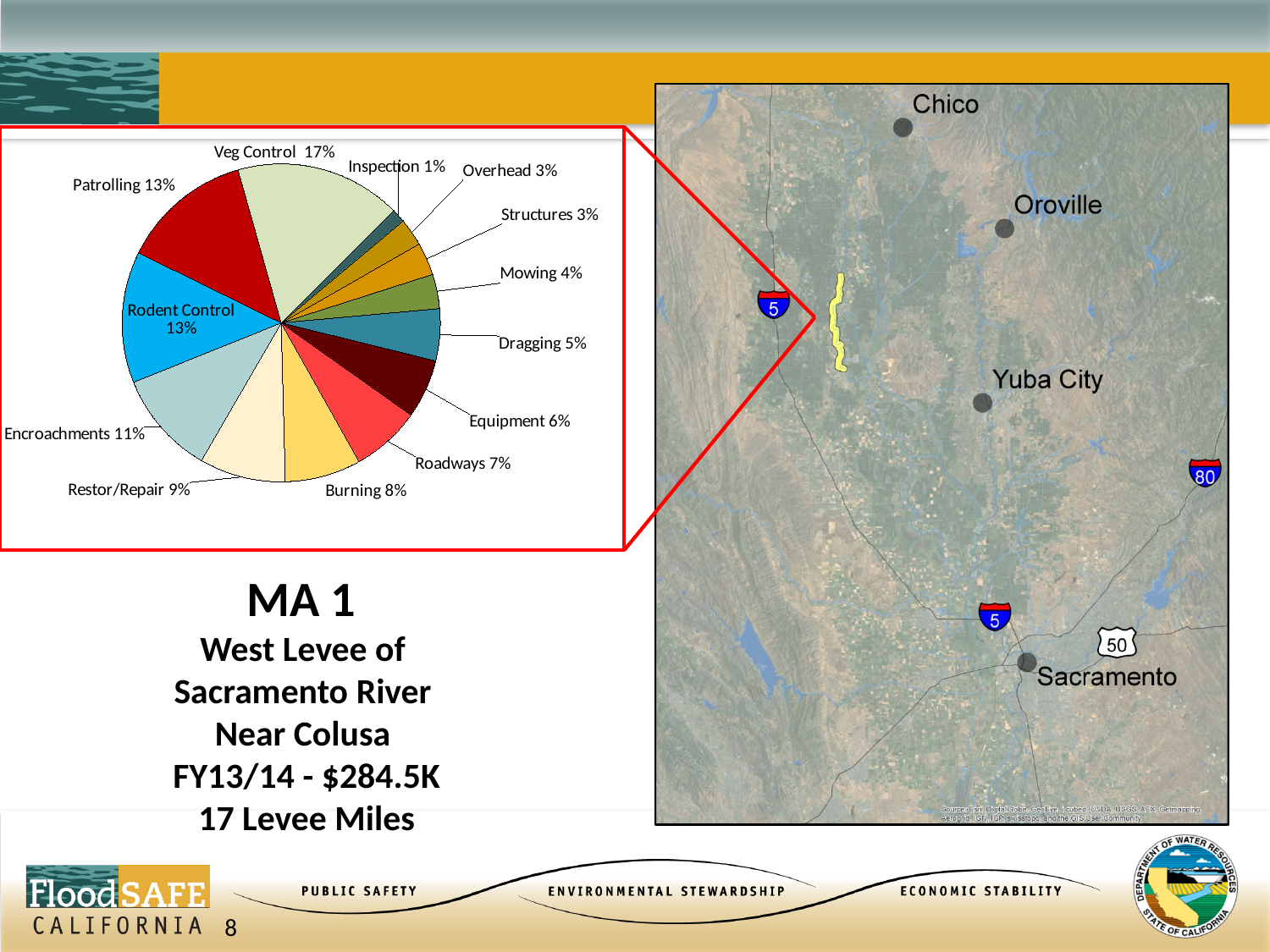
What is the combined percentage of Overhead and Structures? 6% What is the total cost shown for MA 1 in FY13/14 below the chart? $284.5K What kind of chart is shown on the slide? pie chart How many slices does the pie chart have? 13 What share of the pie does Veg Control represent? 17% What is the difference in percentage points between Patrolling and Burning? 5 Which category has the largest slice of the pie? Veg Control What percentage is shown for Restor/Repair? 9% What percentage is shown for Encroachments? 11% What percentage is shown for Mowing? 4% Which category has the smallest slice of the pie? Inspection Which is larger, Roadways or Dragging? Roadways